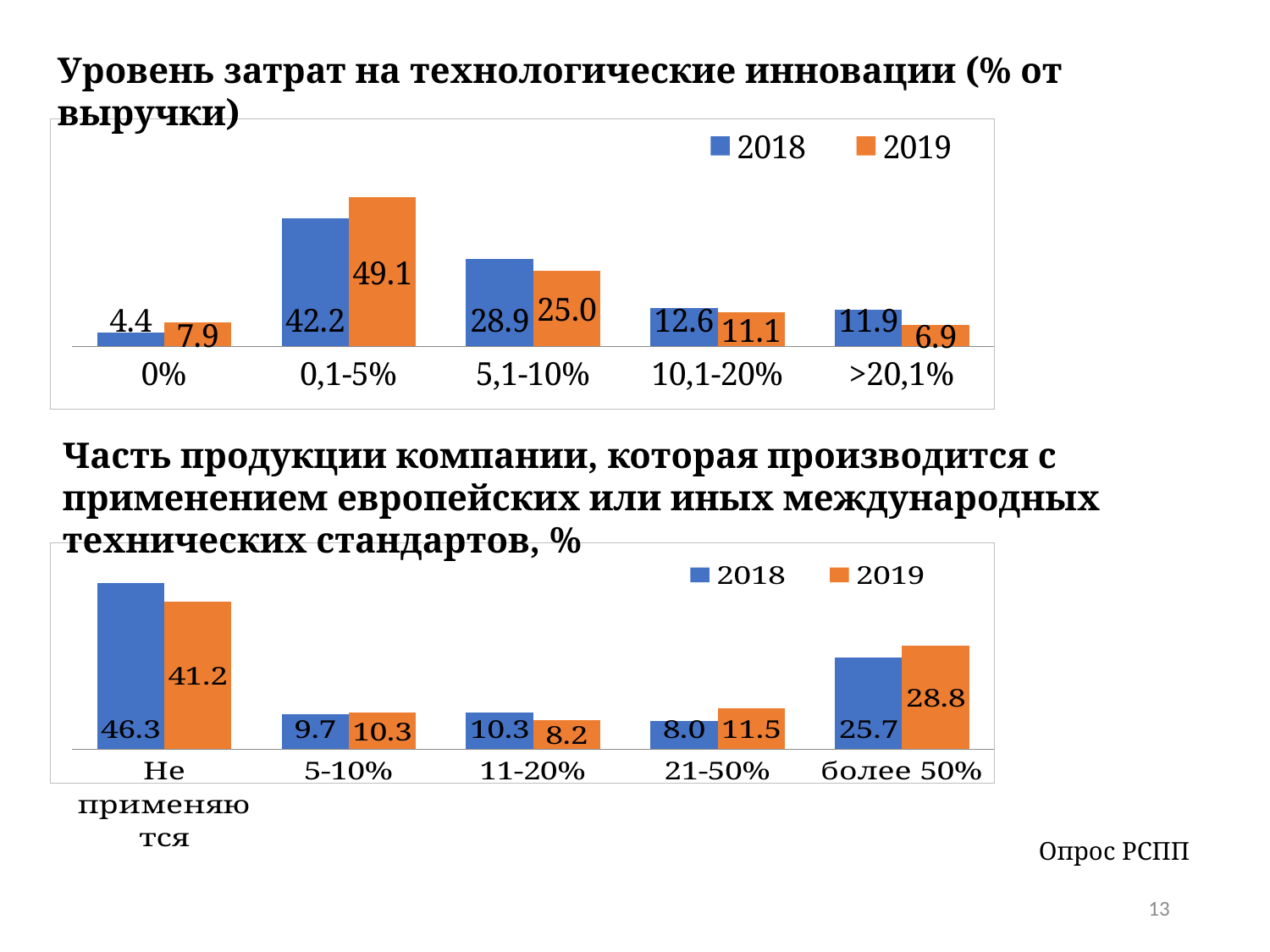
In the top chart (Уровень затрат на технологические инновации), which category has the lowest 2019 value? >20,1% In the bottom chart (Часть продукции компании...), how many series does the legend list? 2 In the top chart (Уровень затрат на технологические инновации), what is the difference between the 2019 and 2018 values for the 0,1-5% category? 6.9 In the bottom chart (Часть продукции компании...), what is the 2019 value for the 'более 50%' category? 28.8 In the top chart (Уровень затрат на технологические инновации), which category has the highest 2018 value? 0,1-5% In the top chart (Уровень затрат на технологические инновации), how many categories are shown on the x axis? 5 In the bottom chart (Часть продукции компании...), what is the 2018 value for the 21-50% category? 8.0 What type of chart is the top chart (Уровень затрат на технологические инновации)? bar chart In the bottom chart (Часть продукции компании...), is the 2018 value for 11-20% larger or smaller than the 2019 value for 11-20%? larger In the top chart (Уровень затрат на технологические инновации), what is the 2018 value for the >20,1% category? 11.9 In the bottom chart (Часть продукции компании...), which category has the highest 2019 value? Не применяются In the top chart (Уровень затрат на технологические инновации), what is the 2019 value for the 0,1-5% category? 49.1